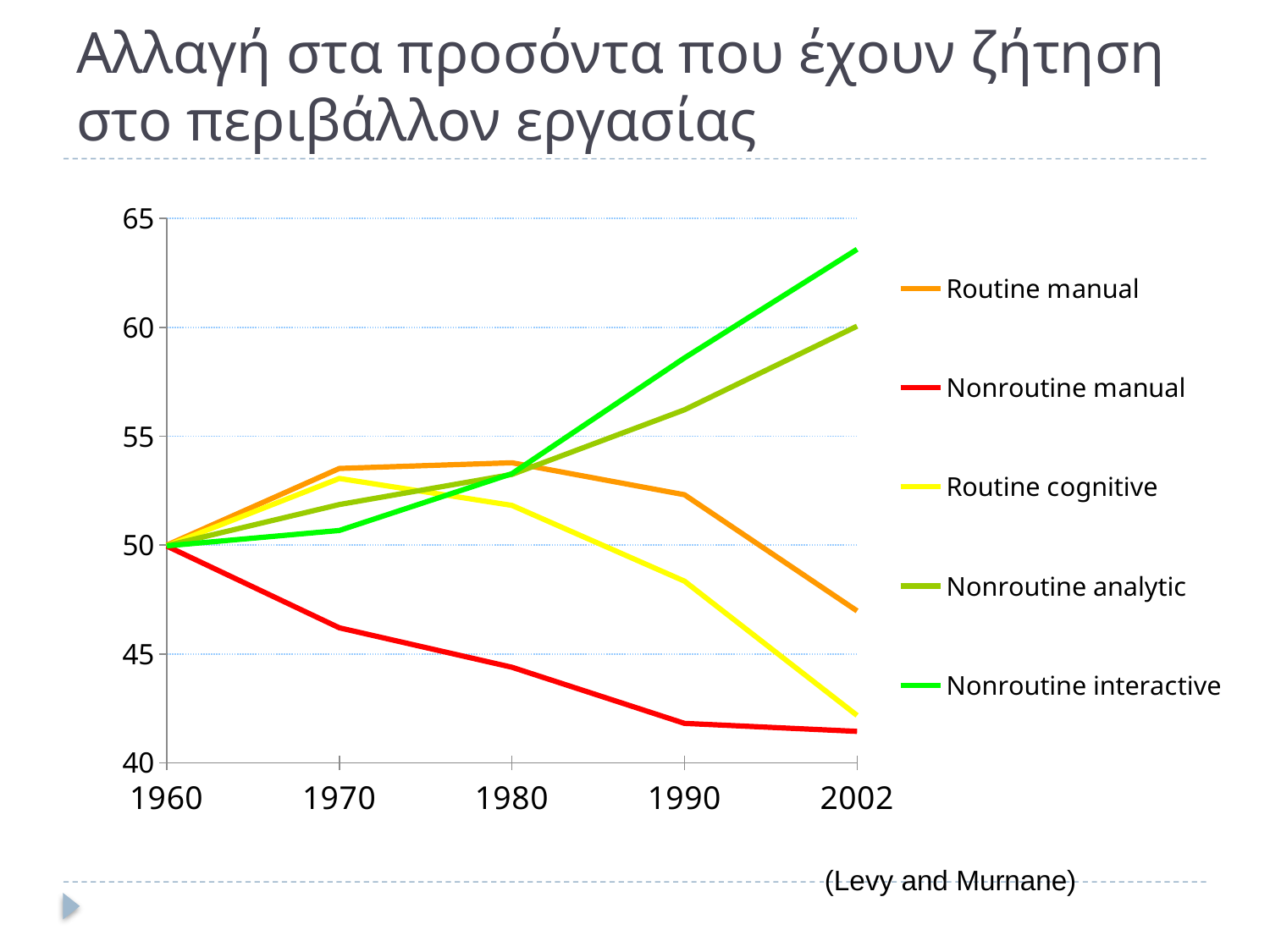
Which series has the highest value in 2002? Nonroutine interactive Is the value for Routine cognitive in 2002 greater or less than 45? less Is the value for Routine manual in 1990 greater or less than 50? greater Does the Nonroutine manual series rise or fall from 1960 to 2002? fall Is the value for Nonroutine interactive in 2002 greater or less than 60? greater How many points are plotted along the x axis for each series? 5 What is the value of all series in 1960? 50 Which series has the lowest value in 2002? Nonroutine manual Which is larger in 2002, Routine manual or Routine cognitive? Routine manual What kind of chart is shown on the slide? line chart Which colour is used for the Nonroutine analytic series? olive green How many series does the legend list? 5